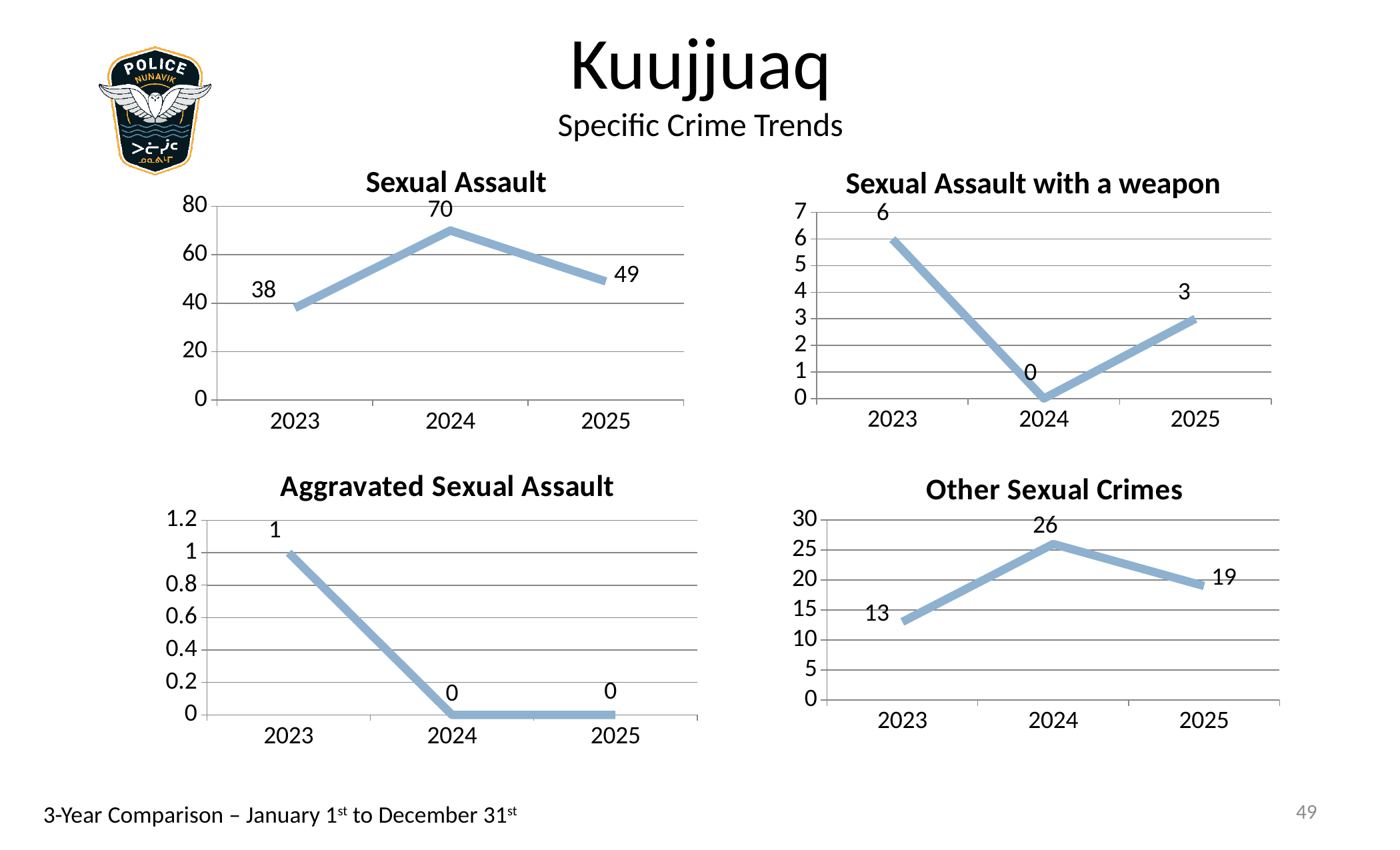
In the Other Sexual Crimes chart, what is the difference between the 2024 and 2023 values? 13 In the Sexual Assault chart, which year has the lowest value? 2023 What kind of chart is the Sexual Assault chart? Line chart In the Other Sexual Crimes chart, do values rise or fall from 2023 to 2024? Rise In the Sexual Assault with a weapon chart, what is the value for 2023? 6 In the Sexual Assault chart, what is the value for 2024? 70 In the Sexual Assault chart, what is the difference between the 2024 and 2025 values? 21 In the Other Sexual Crimes chart, what is the value for 2025? 19 In the Sexual Assault with a weapon chart, which year has the highest value? 2023 In the Sexual Assault with a weapon chart, is the value for 2025 larger than the value for 2024? Yes In the Aggravated Sexual Assault chart, what is the value for 2023? 1 In the Aggravated Sexual Assault chart, how many years are plotted? 3